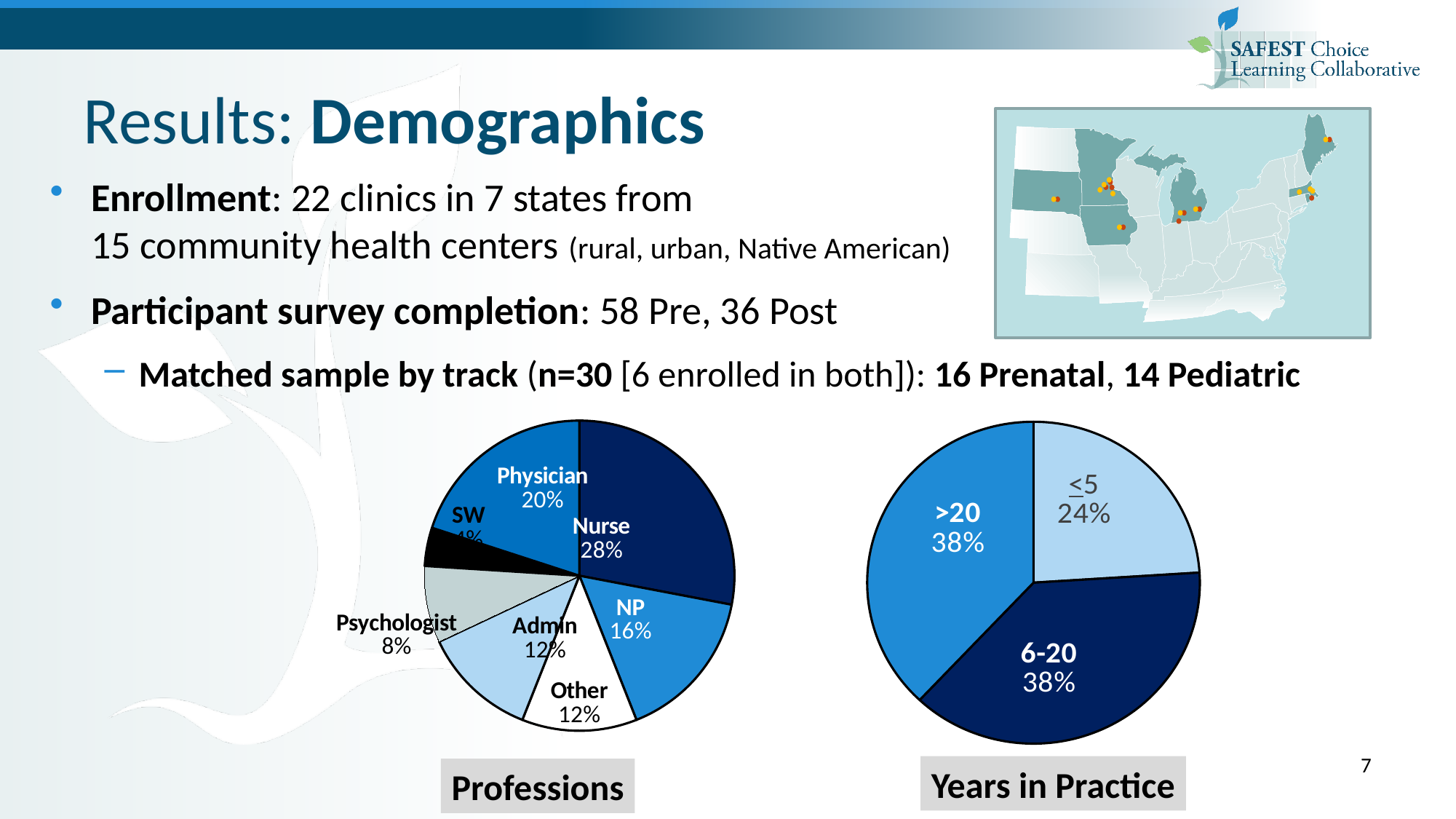
In the Years in Practice pie chart, what share is shown for 6-20 years? 38% In the Professions pie chart, how many percentage points larger is the Nurse share than the Physician share? 8 percentage points In the Professions pie chart, which is larger, the Physician slice or the NP slice? Physician What type of chart is used for Professions? Pie chart In the Years in Practice pie chart, what percentage of participants have 5 or fewer years in practice? 24% In the Professions pie chart, what percentage is shown for NP? 16% In the Professions pie chart, what share is labelled Physician? 20% In the Years in Practice pie chart, which category has the smallest share? ≤5 How many slices does the Professions pie chart have? 7 In the Professions pie chart, what percentage of participants are nurses? 28% How many categories are shown in the Years in Practice pie chart? 3 In the Professions pie chart, which profession has the largest slice? Nurse